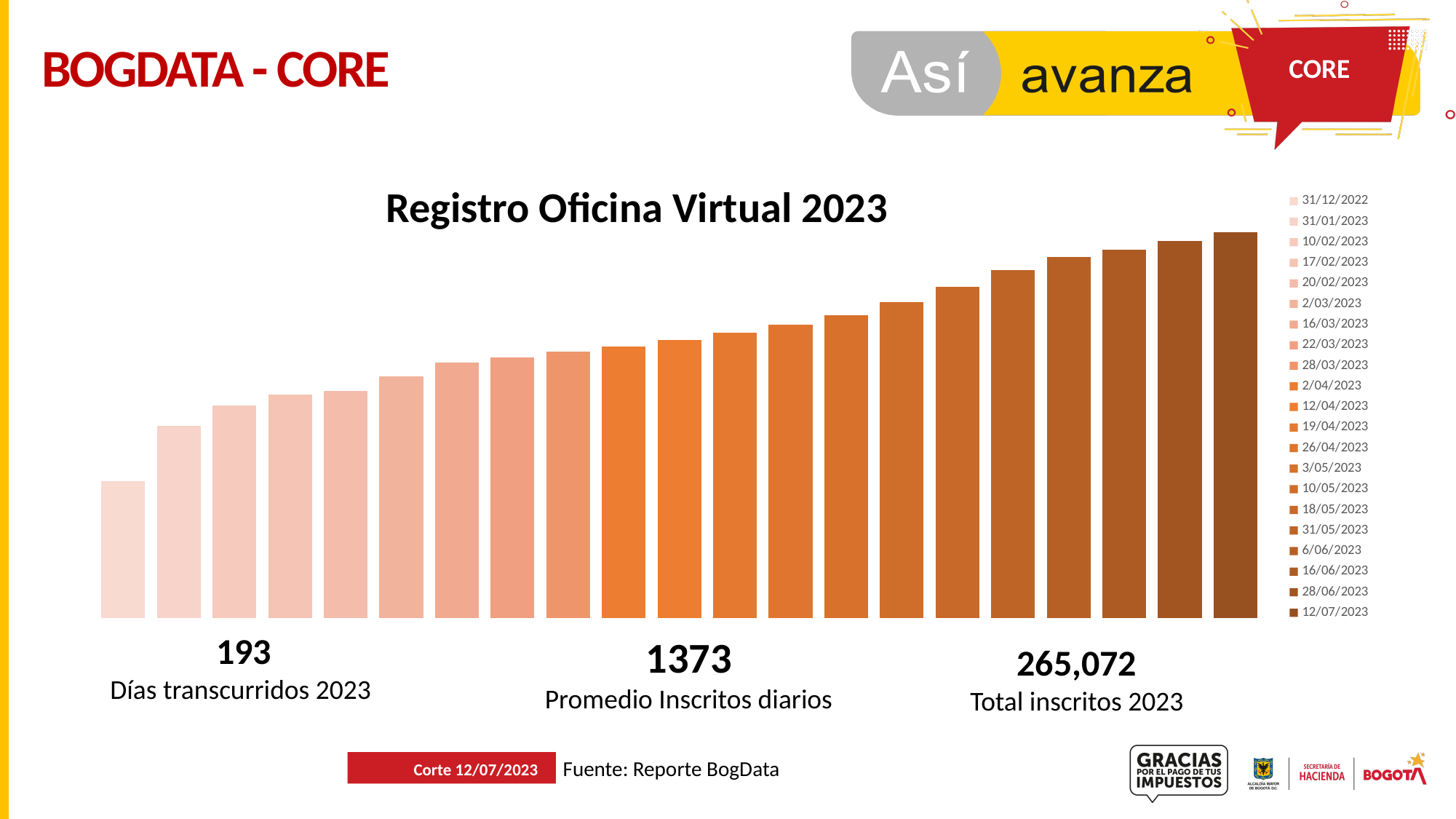
What is the first date listed in the chart legend? 31/12/2022 Which has the larger bar, 31/01/2023 or 28/06/2023? 28/06/2023 Do the bar values rise or fall from left to right across the dates? rise Which has the smaller bar, 16/03/2023 or 3/05/2023? 16/03/2023 What kind of chart is shown on the slide? bar chart Which date has the lowest bar in the chart? 31/12/2022 How many entries does the chart legend list? 21 How many bars (dates) are plotted in the chart? 21 Which date has the highest bar in the chart? 12/07/2023 What is the title of the chart? Registro Oficina Virtual 2023 Which has the larger bar, 2/03/2023 or 10/02/2023? 2/03/2023